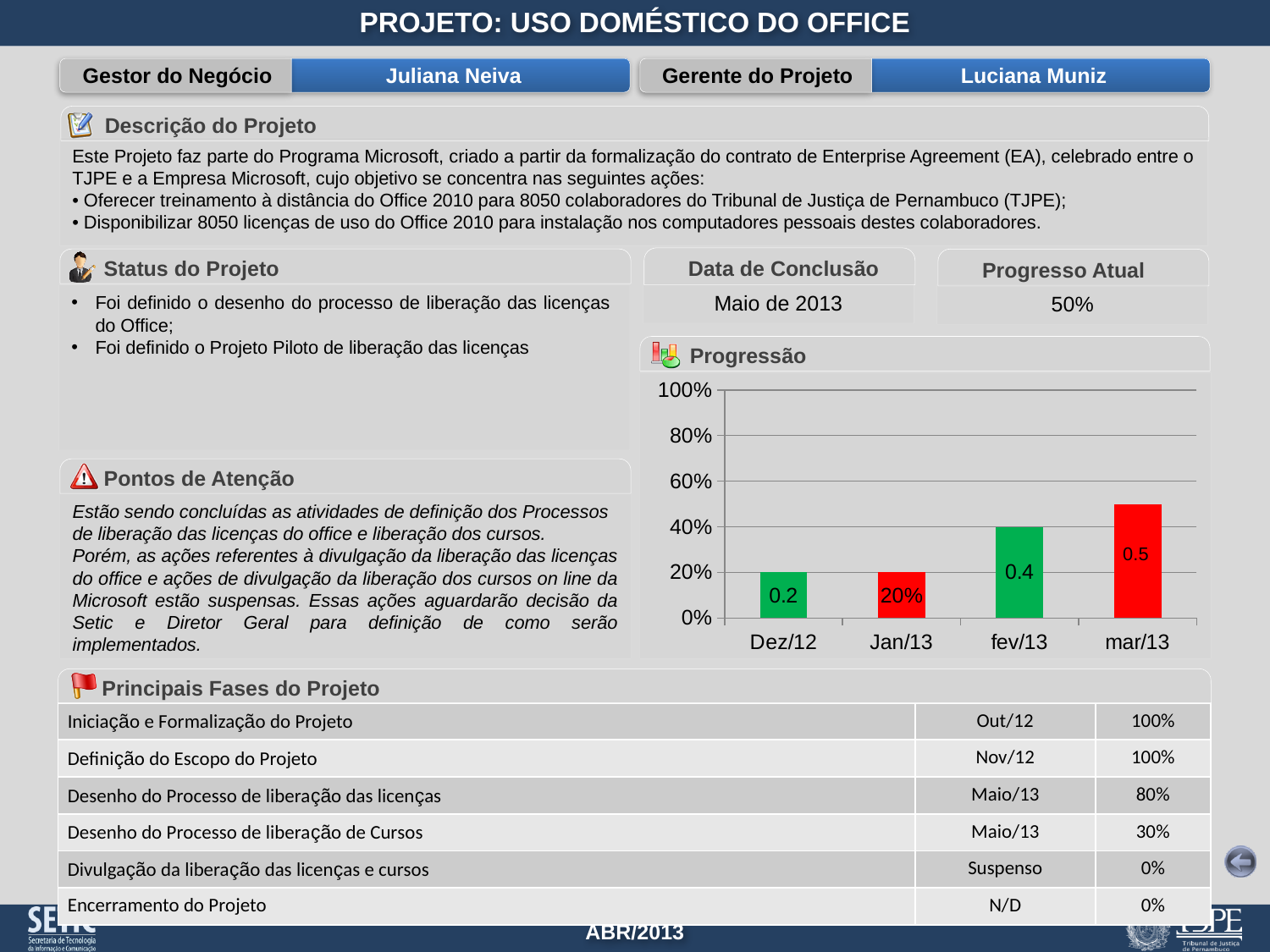
What value is shown for Dez/12 in the Progressão chart? 0.2 What value is shown for fev/13 in the Progressão chart? 0.4 What value is shown for mar/13 in the Progressão chart? 0.5 In the Progressão chart, which is larger, the value for fev/13 or the value for Dez/12? fev/13 What value is shown for Jan/13 in the Progressão chart? 20% What kind of chart is the Progressão chart? bar chart In the Progressão chart, is the value for mar/13 greater or less than 40%? greater What is the difference between the values for mar/13 and fev/13 in the Progressão chart? 0.1 Which month has the highest bar in the Progressão chart? mar/13 Do the values in the Progressão chart rise or fall from Dez/12 to mar/13? rise How many months are plotted in the Progressão chart? 4 What colour is the mar/13 bar in the Progressão chart? red